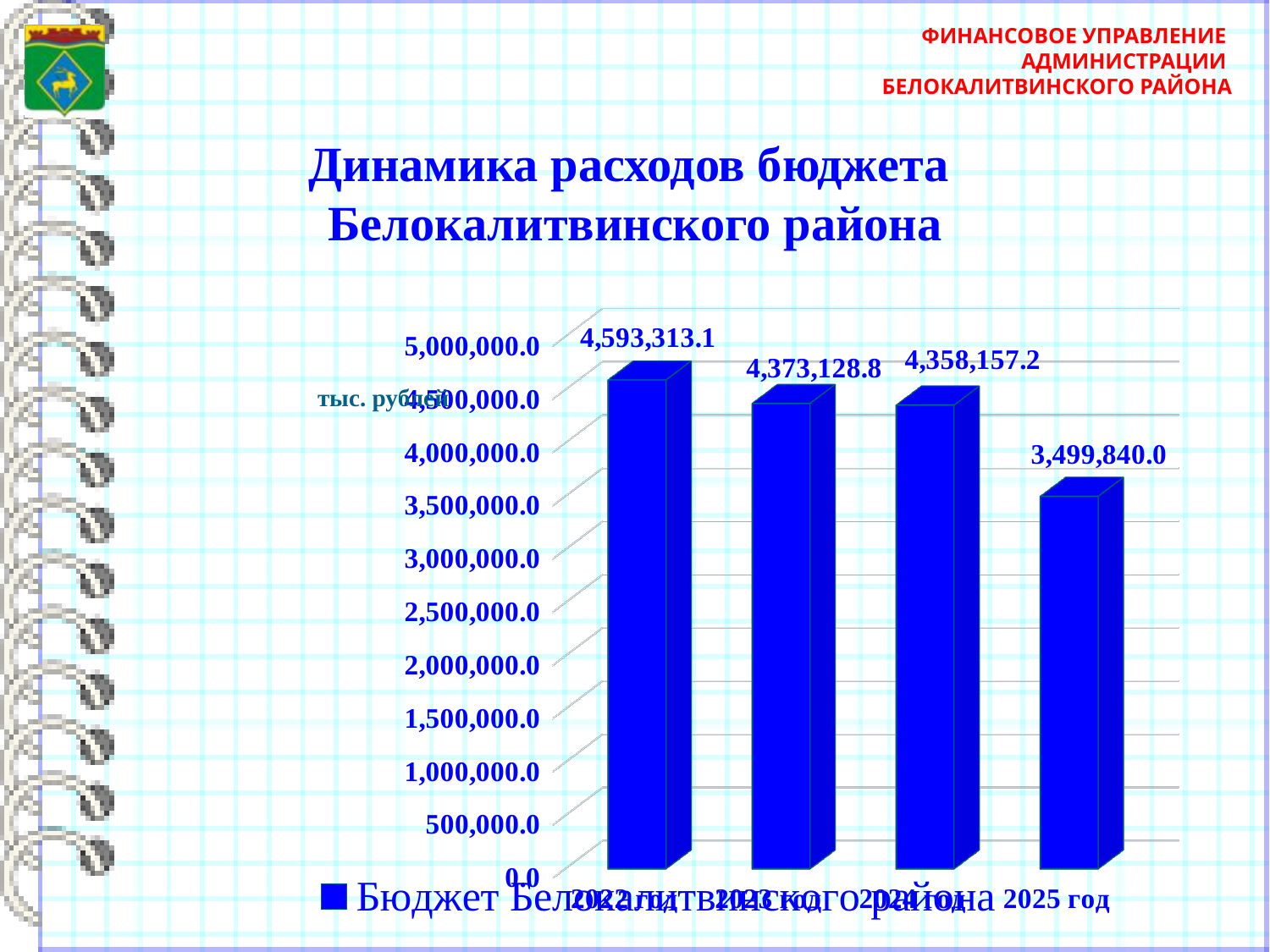
What is the value of the third bar from the left? 4,358,157.2 What is the title of the chart? Динамика расходов бюджета Белокалитвинского района Is the value for 2025 год greater or less than 4,000,000.0? less Which bar has the lowest value? 2025 год (3,499,840.0) Do the values rise or fall from left to right along the x axis? Fall What kind of chart is shown on the slide? Bar chart How many bars are shown in the chart? 4 What is the value of the bar for 2025 год? 3,499,840.0 What is the value of the second bar from the left? 4,373,128.8 What is the difference between the leftmost bar and the bar for 2025 год? 1,093,473.1 Which bar has the highest value? The leftmost bar (4,593,313.1) What is the value of the leftmost bar in the chart? 4,593,313.1